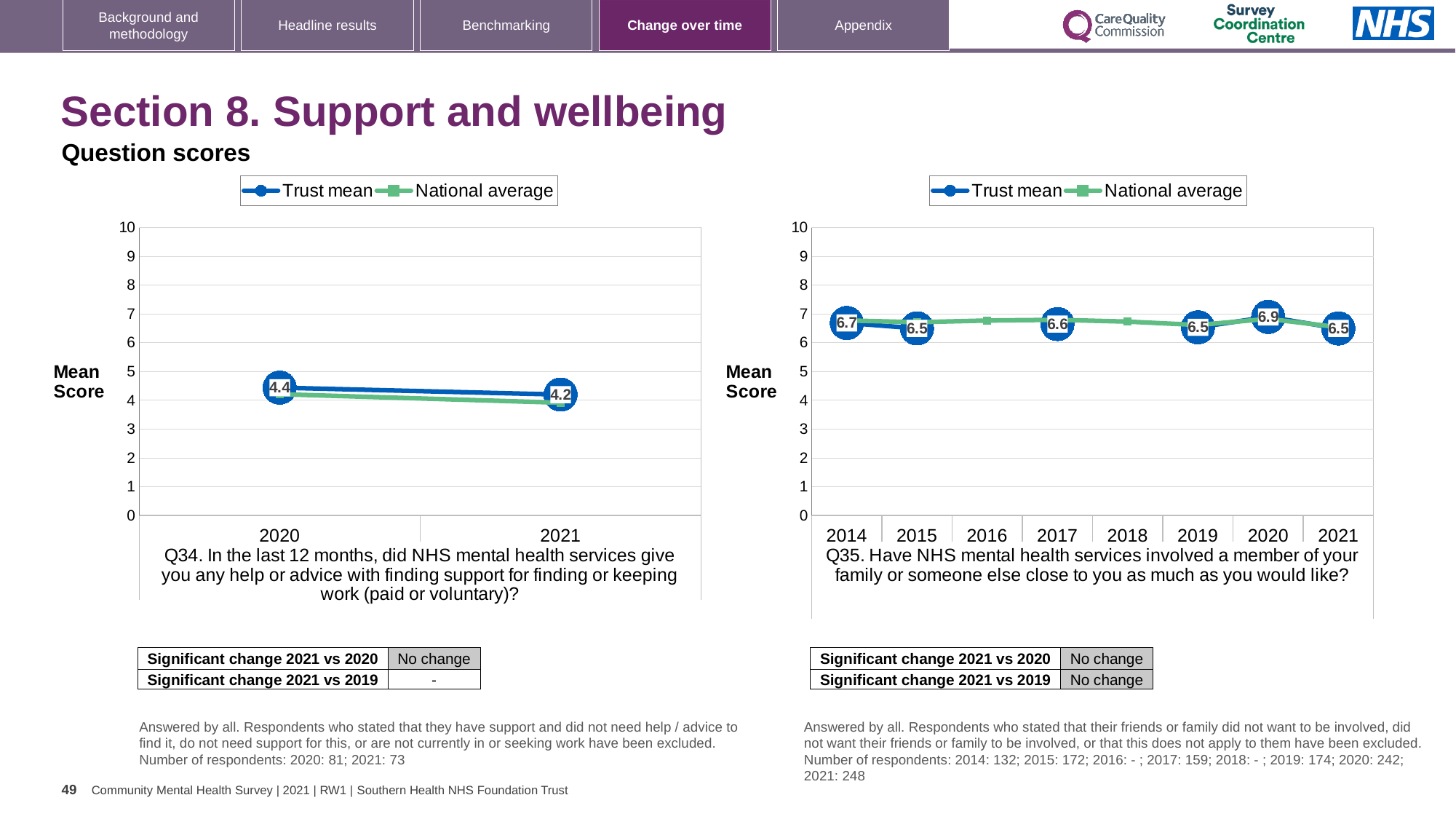
In the Q34 chart on the left, what is the Trust mean for 2021? 4.2 What kind of chart is the Q34 chart on the left? line chart In the Q34 chart on the left, what is the difference between the Trust mean for 2020 and 2021? 0.2 In the Q34 chart on the left, does the Trust mean rise or fall from 2020 to 2021? fall In the Q35 chart on the right, what is the Trust mean for 2014? 6.7 In the Q35 chart on the right, what is the Trust mean for 2020? 6.9 In the Q35 chart on the right, which year has the highest Trust mean? 2020 In the Q35 chart on the right, what is the difference between the Trust mean for 2020 and 2021? 0.4 In the Q35 chart on the right, how many years are shown on the x axis? 8 In the Q34 chart on the left, is the Trust mean for 2021 greater or less than 5? less How many series does the legend of the Q35 chart on the right list? 2 In the Q34 chart on the left, what is the Trust mean for 2020? 4.4